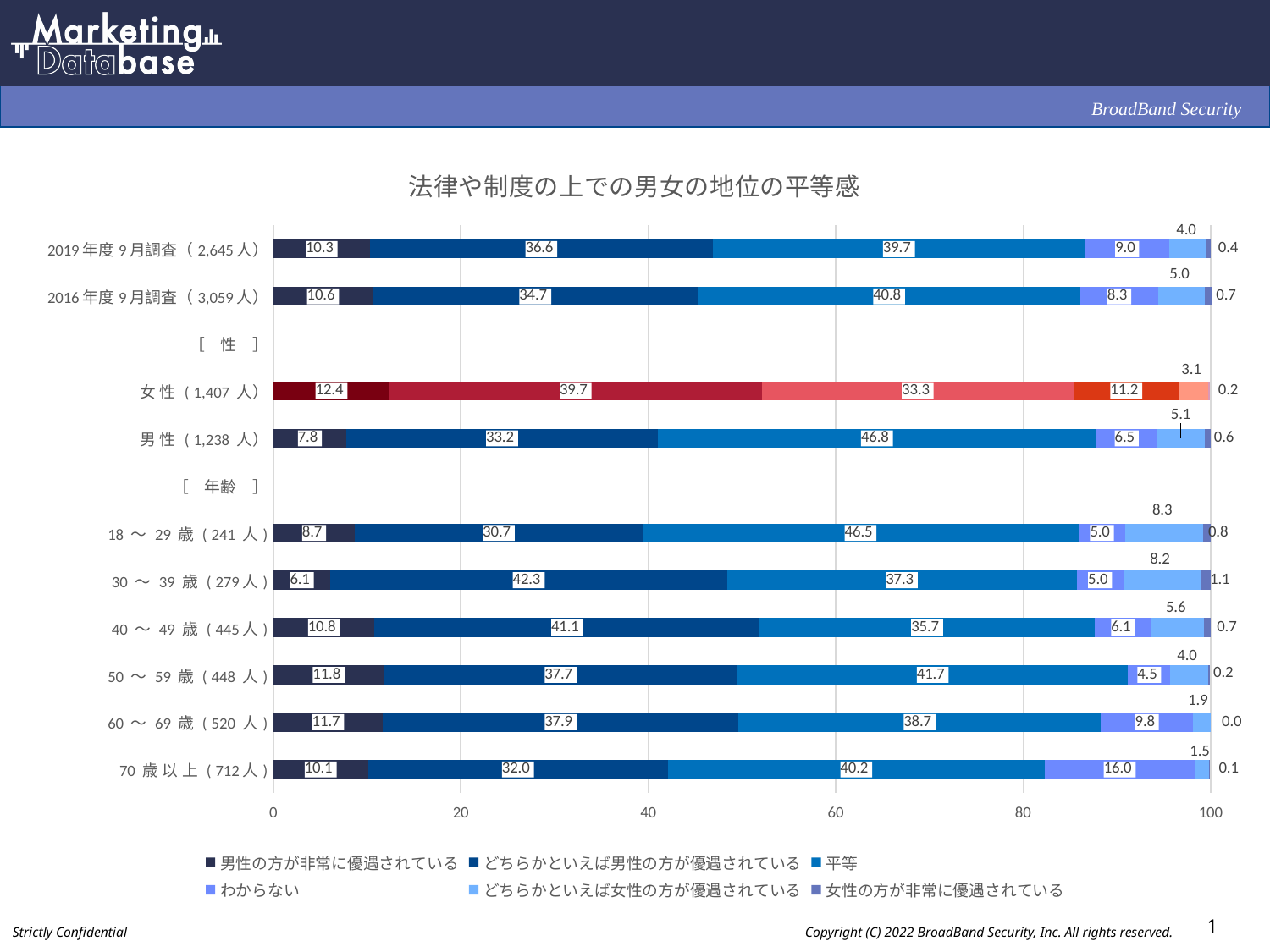
What is the difference in 男性の方が非常に優遇されている between 女性 (1,407 人) and 男性 (1,238 人)? 4.6 Which has the larger value for どちらかといえば男性の方が優遇されている, 女性 (1,407 人) or 男性 (1,238 人)? 女性 (1,407 人) What is the value of 平等 for 男性 (1,238 人)? 46.8 Which category has the lowest value for 男性の方が非常に優遇されている? 30 〜 39 歳 (279人) What is the value of どちらかといえば男性の方が優遇されている for 30 〜 39 歳 (279人)? 42.3 What is the title of the chart? 法律や制度の上での男女の地位の平等感 What is the difference in 平等 between 2016年度9月調査 and 2019年度9月調査? 1.1 What is the value of 平等 for 70 歳以上 (712人)? 40.2 How many series does the legend list? 6 How many categories have bars plotted in the chart? 10 What kind of chart is shown on the slide? Stacked bar chart What is the value of 男性の方が非常に優遇されている for 女性 (1,407 人)? 12.4